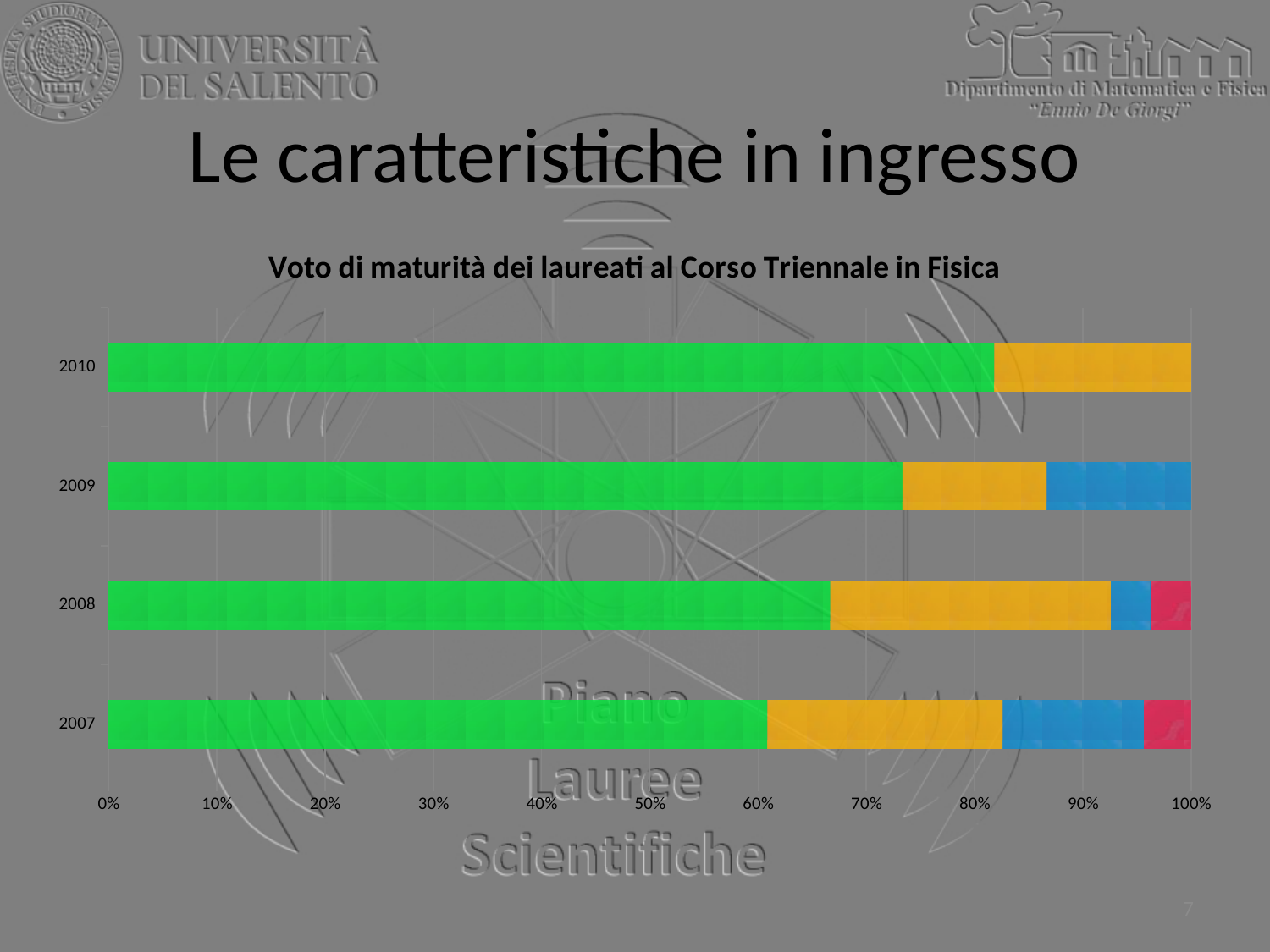
Which year has a larger green segment, 2009 or 2008? 2009 Which year has the largest green segment? 2010 What kind of chart is shown on the slide? Stacked bar chart Is the green segment for 2007 greater or less than 50%? greater Does the green segment grow or shrink going from 2007 up to 2010? grows How many coloured segments make up the bar for 2010? 2 How many years (categories) are shown on the chart? 4 Is the green segment for 2009 greater or less than 80%? less Which year has the smallest green segment? 2007 Is the green segment for 2008 greater or less than 60%? greater What is the title of the chart? Voto di maturità dei laureati al Corso Triennale in Fisica